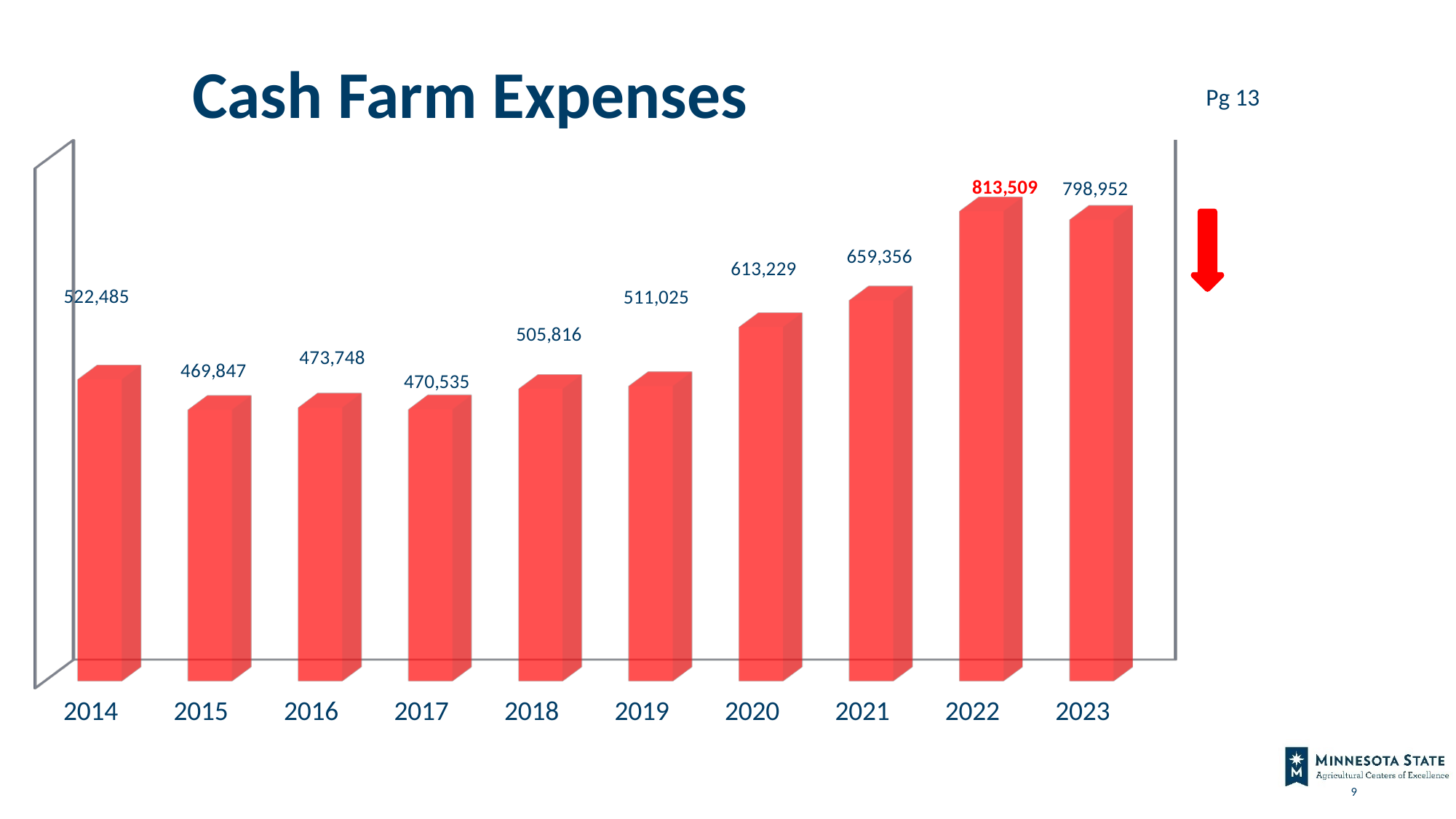
What is the title of the chart? Cash Farm Expenses What is the value for 2023? 798,952 Which year has the highest cash farm expenses? 2022 What is the difference between the values for 2022 and 2023? 14,557 What is the value for 2020? 613,229 Do the values generally rise or fall from 2017 to 2022? rise Which year has the lowest cash farm expenses? 2015 Which is larger, the value for 2018 or the value for 2019? 2019 How many years are shown on the x axis? 10 What is the value for 2014? 522,485 What kind of chart is this? bar chart What is the difference between the values for 2021 and 2020? 46,127